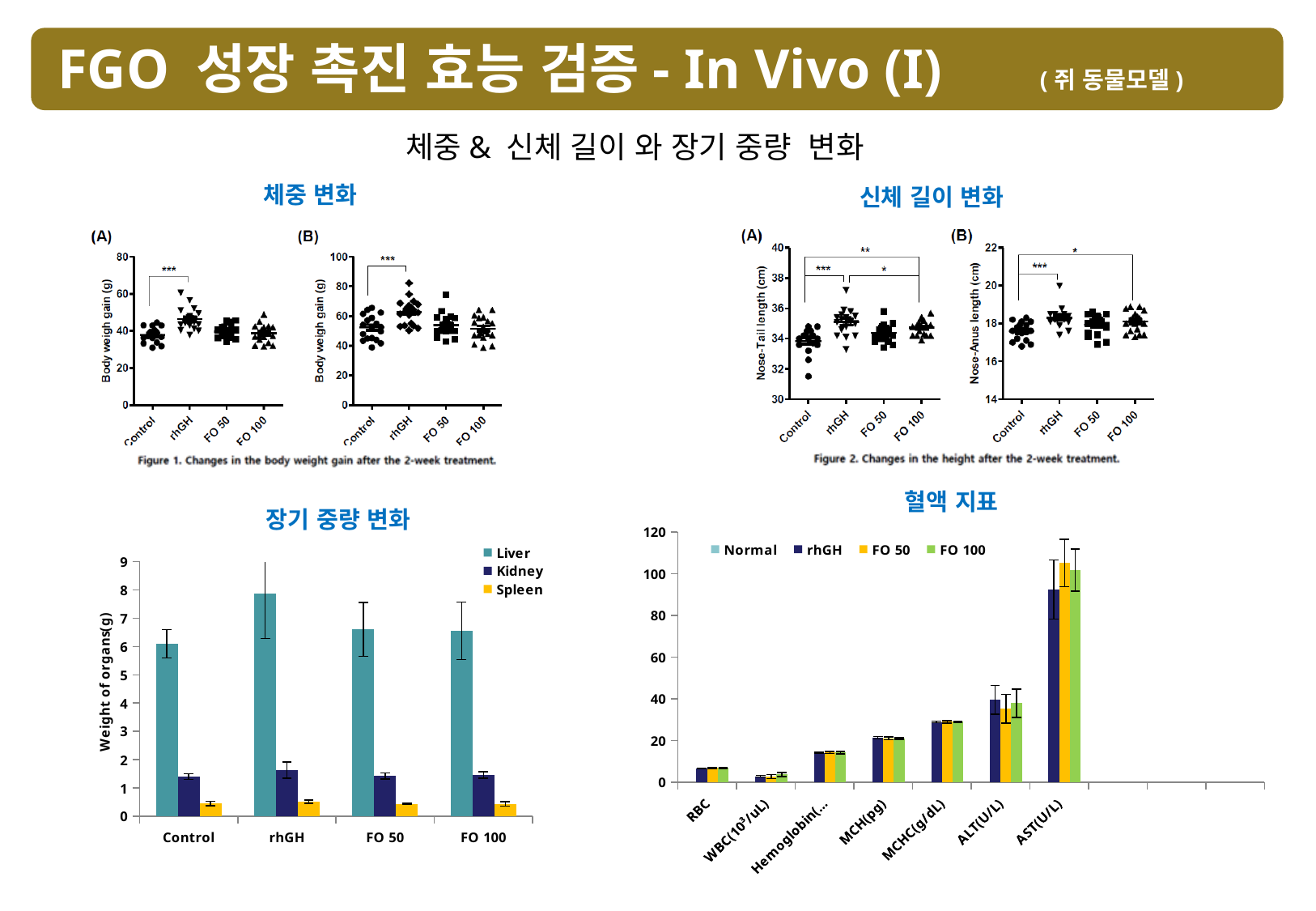
In the 혈액 지표 chart, which parameter has the highest values? AST(U/L) How many series does the legend of the 혈액 지표 chart list? 4 How many series does the legend of the 장기 중량 변화 chart list? 3 In the 장기 중량 변화 chart, which is larger for Control, the Liver value or the Kidney value? Liver In the 장기 중량 변화 chart, is the Liver value for rhGH greater or less than 7? greater In the 혈액 지표 chart, is the Normal value for MCHC(g/dL) greater or less than 40? less In the 혈액 지표 chart, is the rhGH value for AST(U/L) greater or less than 80? greater What kind of chart is the 장기 중량 변화 chart? bar chart How many blood parameters are shown on the x axis of the 혈액 지표 chart? 7 How many groups are shown on the x axis of the 장기 중량 변화 chart? 4 In the 장기 중량 변화 chart, which group has the highest Liver weight? rhGH